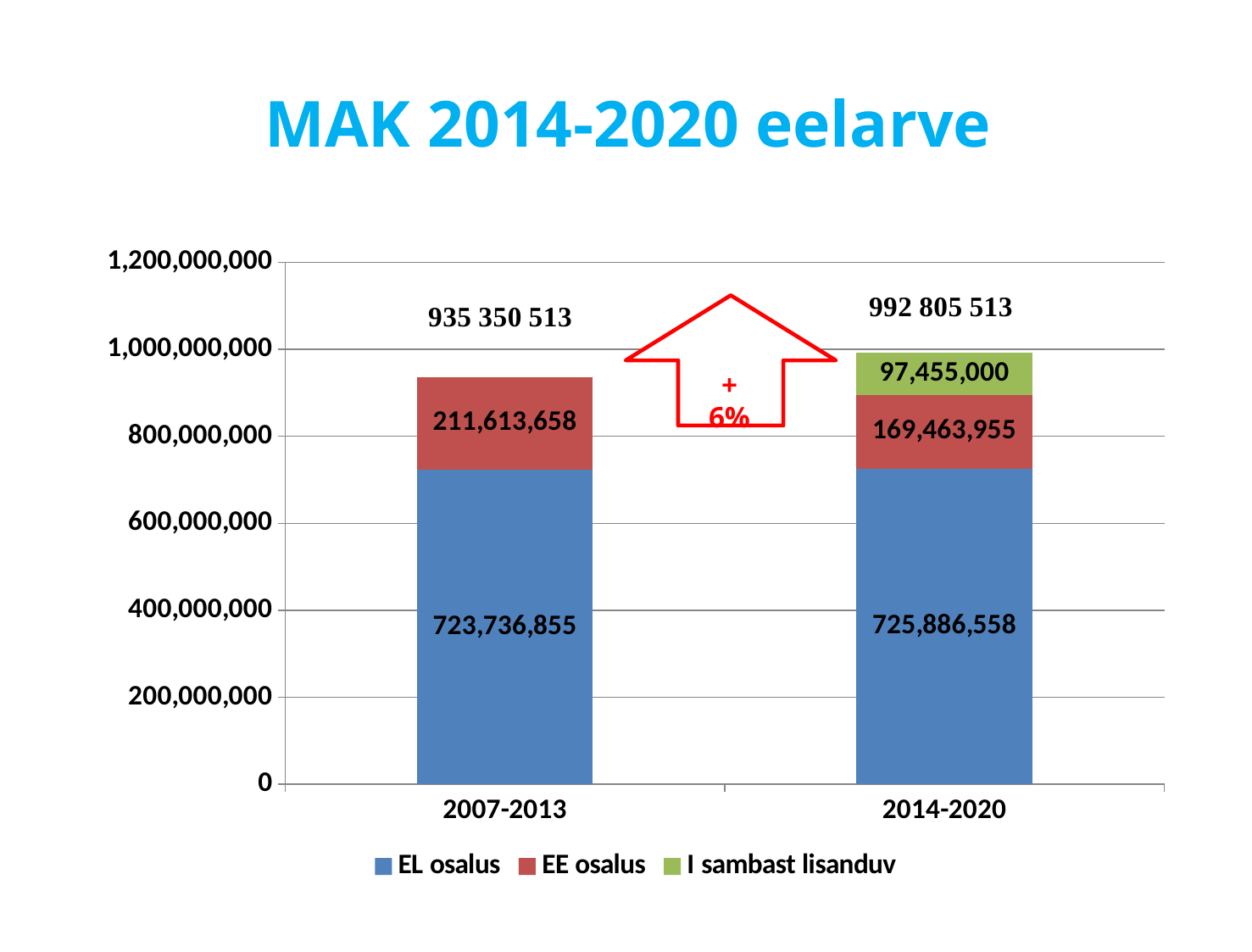
What is the value of I sambast lisanduv for 2014-2020? 97,455,000 What is the total of the stacked bar for 2007-2013? 935 350 513 What is the value of EE osalus for 2014-2020? 169,463,955 How many categories are shown on the x axis? 2 What is the total of the stacked bar for 2014-2020? 992 805 513 What is the difference between EE osalus in 2007-2013 and EE osalus in 2014-2020? 42,149,703 What is the value of EE osalus for 2007-2013? 211,613,658 Which period has the larger EE osalus value, 2007-2013 or 2014-2020? 2007-2013 How many series does the legend list? 3 Is the total for 2007-2013 greater or less than 1,000,000,000? less What is the value of EL osalus for 2007-2013? 723,736,855 What kind of chart is shown on the slide? Stacked bar chart